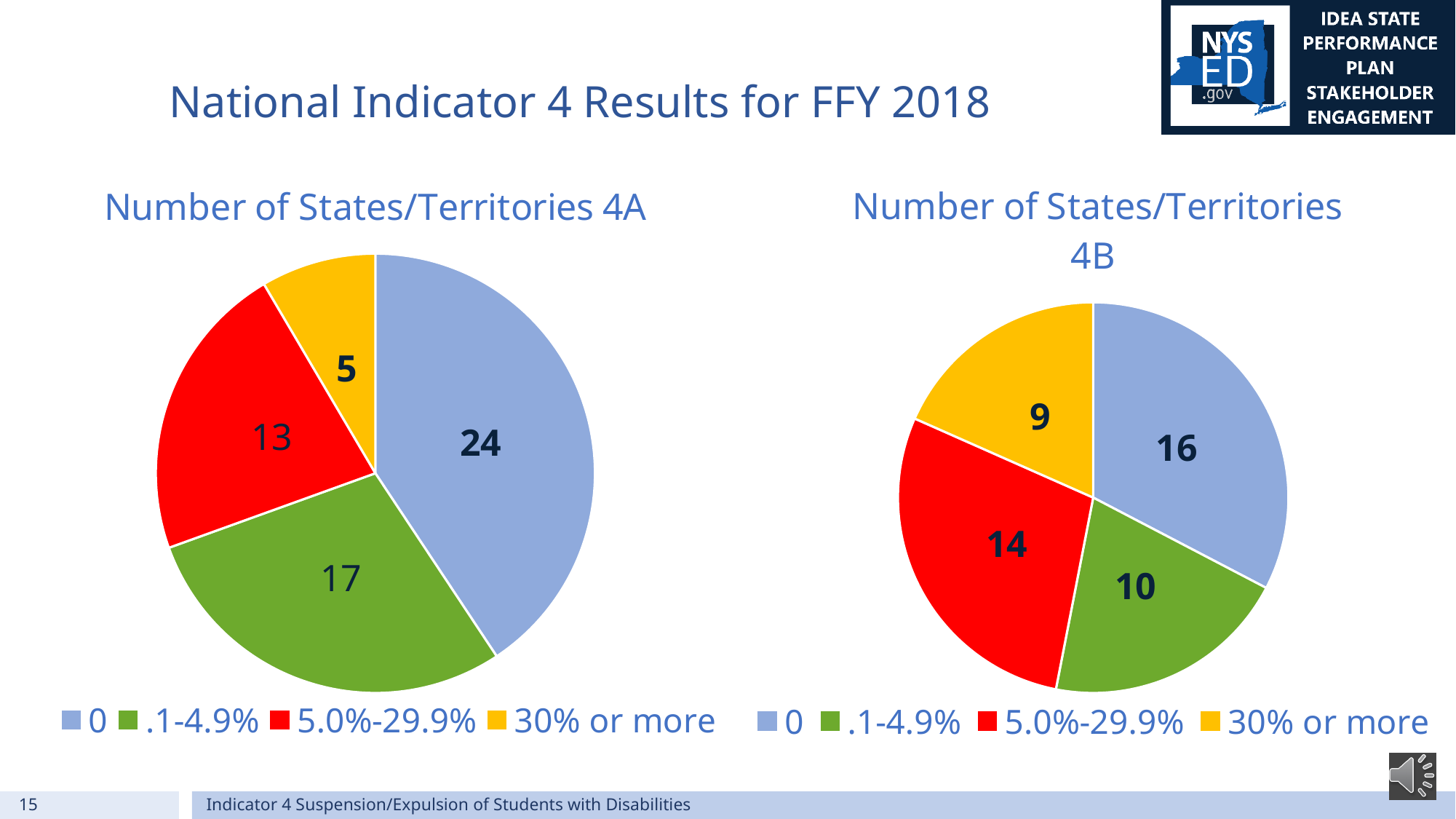
In the 'Number of States/Territories 4A' chart, which category has the largest number of states/territories? 0 In the 'Number of States/Territories 4B' chart, how many states/territories are in the '5.0%-29.9%' category? 14 In the 'Number of States/Territories 4A' chart, what colour is the '5.0%-29.9%' slice? Red What is the total number of states/territories across all slices in the 'Number of States/Territories 4B' chart? 49 In the 'Number of States/Territories 4B' chart, what is the value for the '.1-4.9%' category? 10 In the 'Number of States/Territories 4A' chart, what is the difference between the '0' category and the '.1-4.9%' category? 7 In the 'Number of States/Territories 4B' chart, which is larger: the '5.0%-29.9%' category or the '.1-4.9%' category? 5.0%-29.9% How many categories does the 'Number of States/Territories 4A' pie chart have? 4 In the 'Number of States/Territories 4A' chart, what is the value for the '30% or more' category? 5 What type of chart is 'Number of States/Territories 4B'? Pie chart In the 'Number of States/Territories 4B' chart, which category has the smallest number of states/territories? 30% or more In the 'Number of States/Territories 4A' chart, how many states/territories are in the '0' category? 24